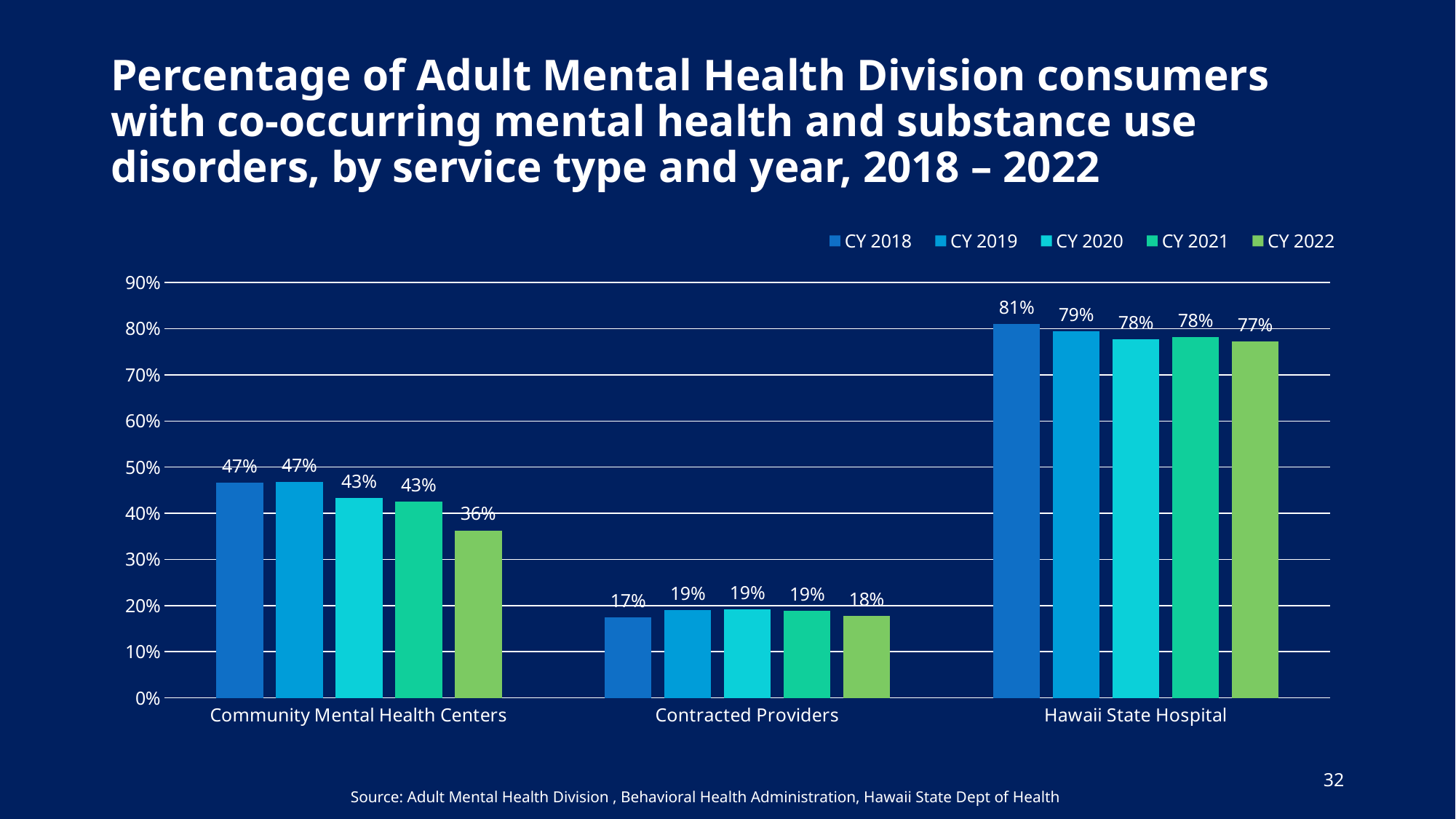
Do the values for Hawaii State Hospital rise or fall from CY 2018 to CY 2022? Fall Which service type has the highest value in CY 2020? Hawaii State Hospital What kind of chart is shown on the slide? Bar chart What is the value for Community Mental Health Centers in CY 2022? 36% What is the value for Contracted Providers in CY 2018? 17% What is the difference between the CY 2018 and CY 2022 values for Community Mental Health Centers? 11 percentage points What is the value for Hawaii State Hospital in CY 2018? 81% Is the CY 2022 value for Hawaii State Hospital greater or less than 70%? greater How many service types are shown on the x axis? 3 Which service type has the lowest value in CY 2021? Contracted Providers Which is larger: the CY 2019 value for Community Mental Health Centers or the CY 2019 value for Contracted Providers? Community Mental Health Centers How many series does the legend list? 5